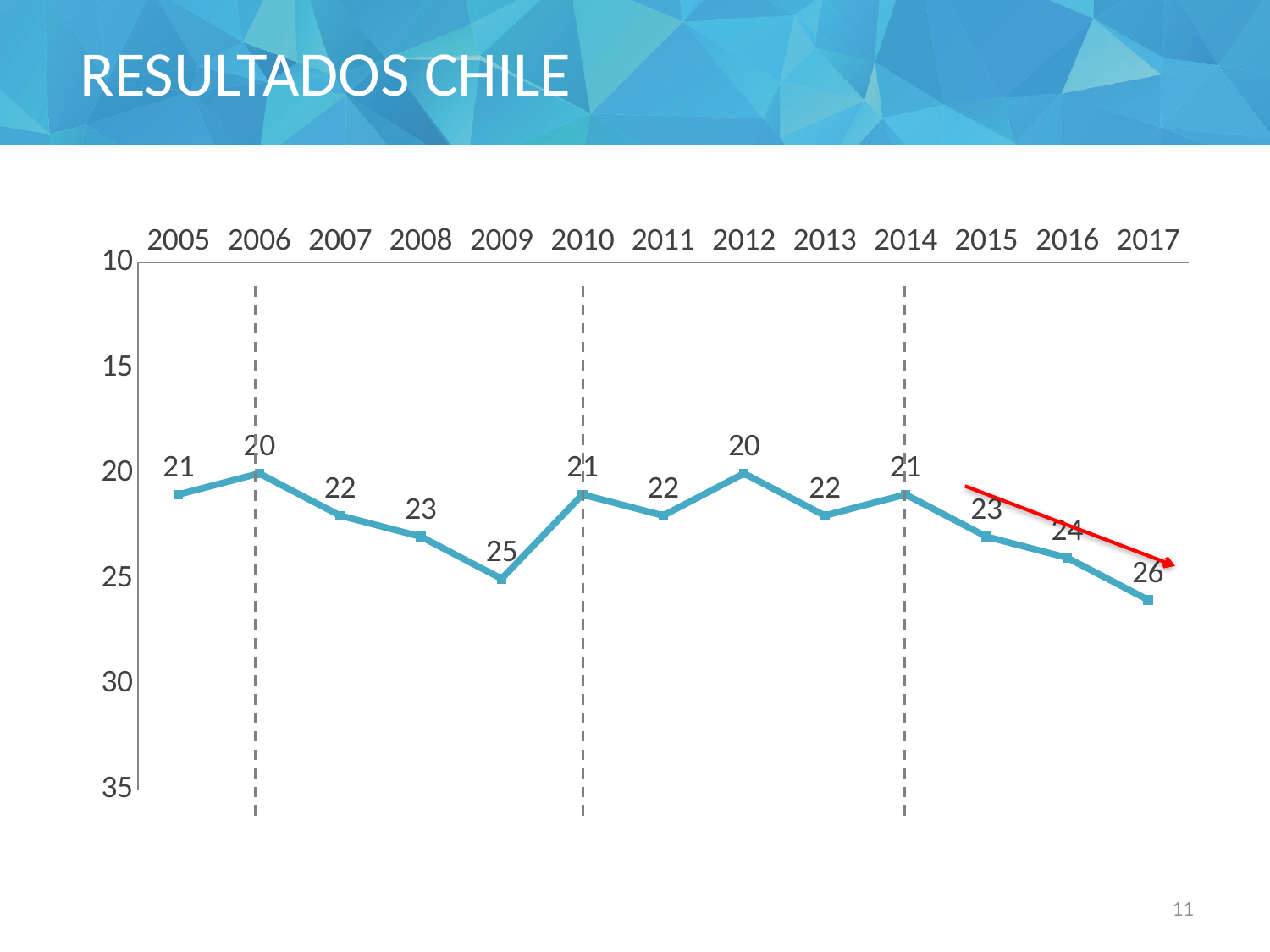
Which is larger, the value for 2008 or the value for 2013? 2008 What is the value for 2012? 20 Which year has the highest value? 2017 What is the value for 2005? 21 What kind of chart is shown on the slide? line chart What is the value for 2017? 26 What is the title of the slide? RESULTADOS CHILE Do the values rise or fall from 2014 to 2017? rise What is the value for 2009? 25 What is the difference between the values for 2009 and 2010? 4 What is the difference between the values for 2017 and 2014? 5 How many years are plotted on the chart? 13